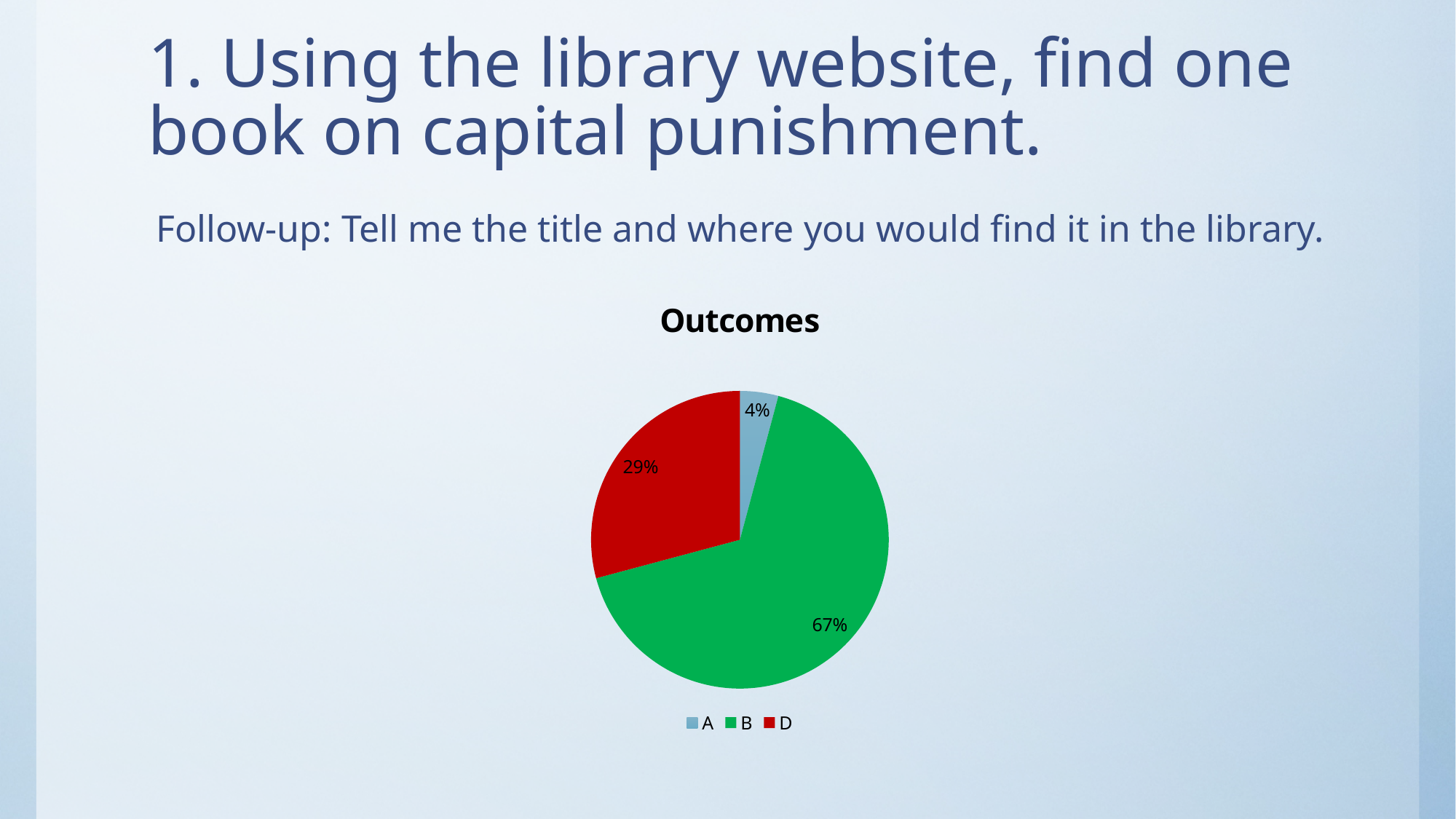
What is the difference in percentage points between the shares of B and D? 38 What share of the pie does category A have? 4% Which has a larger share, D or A? D Which category has the smallest slice of the pie? A Which category has the largest slice of the pie? B Is the share for B greater or less than 50%? greater Which colour represents category D in the pie chart? red What kind of chart is shown on the slide? pie chart How many categories does the legend list? 3 What share of the pie does category B have? 67% What share of the pie does category D have? 29% What is the title of the chart? Outcomes